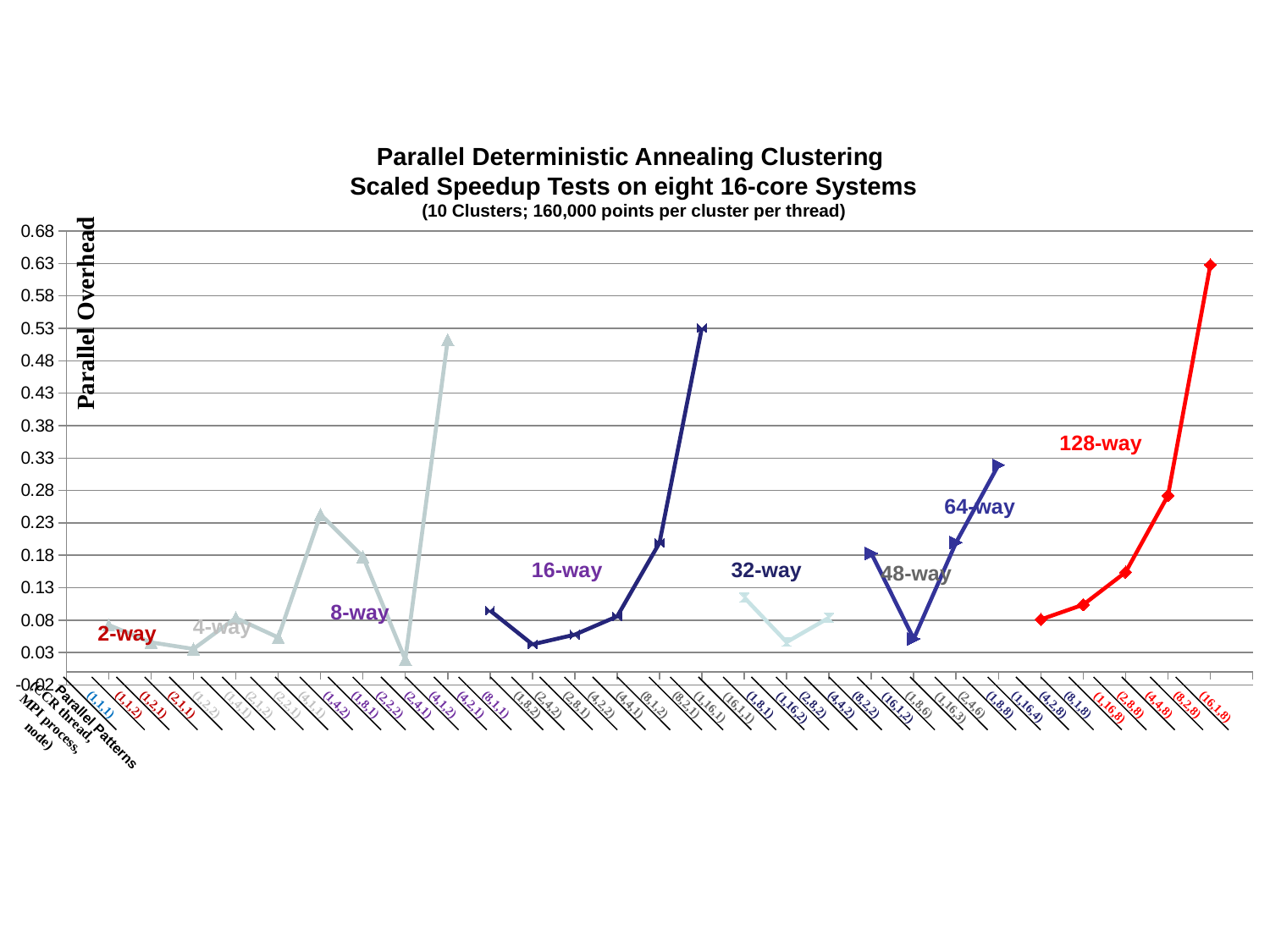
Is the parallel overhead for the 8-way pattern (4,1,2) greater or less than 0.43? greater Is the parallel overhead for the 128-way pattern (16,1,8) greater or less than 0.58? greater Which series reaches the highest parallel overhead on the chart? 128-way What is the label of the vertical axis? Parallel Overhead What kind of chart is shown on the slide? line chart Is the parallel overhead for the 32-way pattern (1,16,2) greater or less than 0.08? less Which has the larger parallel overhead: the 128-way pattern (16,1,8) or the 16-way pattern (1,16,1)? 128-way (16,1,8) What is the main title of the chart? Parallel Deterministic Annealing Clustering Scaled Speedup Tests on eight 16-core Systems Does the parallel overhead for the 128-way series rise or fall from left to right along the x axis? rise